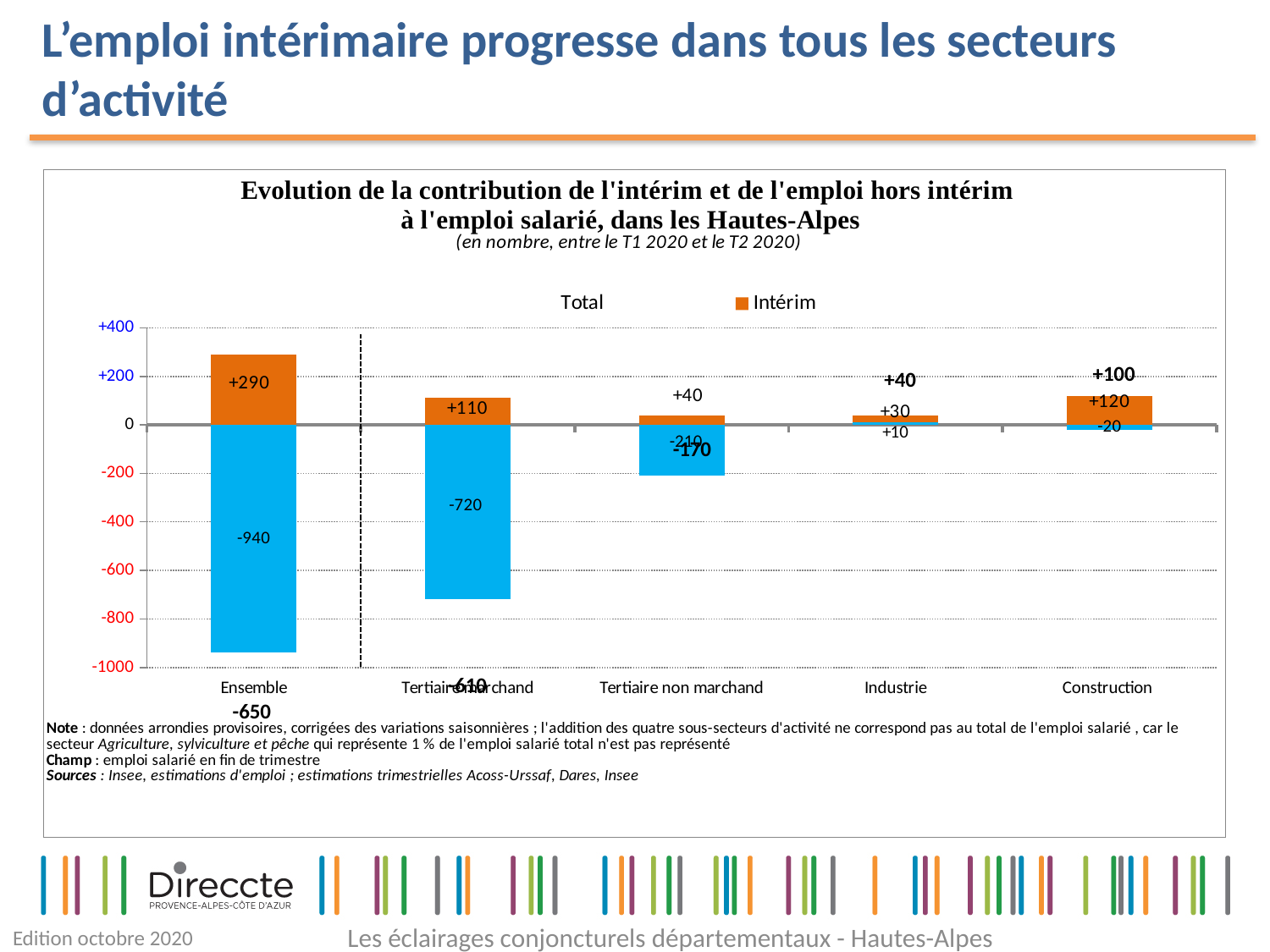
Which has the larger Intérim value, Tertiaire marchand or Construction? Construction What is the value of the blue bar for Tertiaire marchand? -720 Is the blue bar value for Ensemble greater or less than -800? less Which category has the lowest blue bar value? Ensemble What is the Intérim value for Industrie? +30 What is the difference between the Intérim values for Construction and Industrie? 90 What kind of chart is shown on the slide? bar chart Which category has the highest Intérim value? Ensemble How many categories are shown on the x axis? 5 What is the total value shown for Construction? +100 What is the Intérim value for Ensemble? +290 What is the total value shown for Ensemble? -650